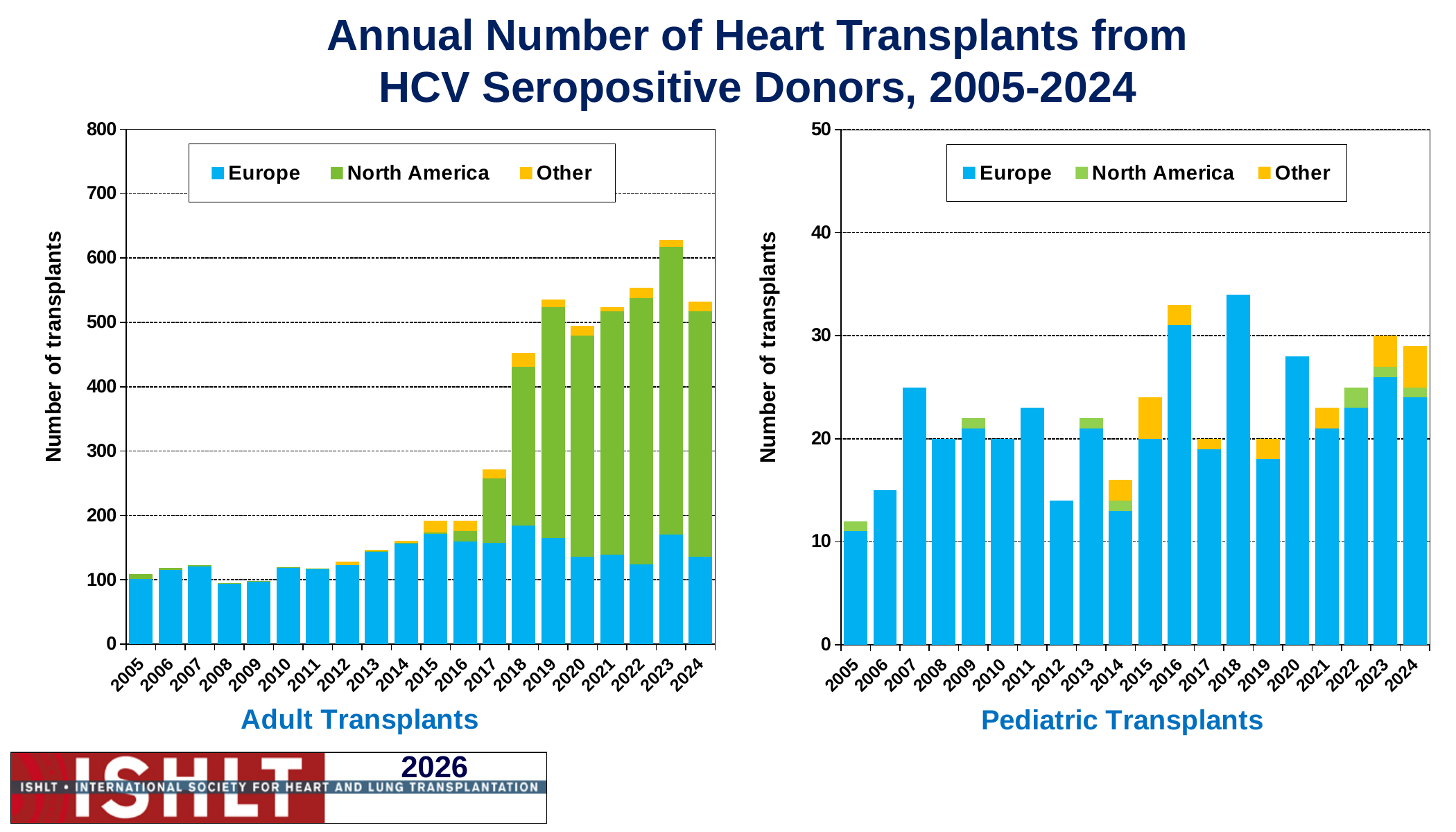
In the Pediatric Transplants chart, is the total for 2012 greater or less than 20? less How many series does the legend of the Pediatric Transplants chart list? 3 What kind of chart is the Adult Transplants chart? bar chart In the Pediatric Transplants chart, which year has the larger total, 2007 or 2012? 2007 In the Pediatric Transplants chart, is the total for 2018 greater or less than 30? greater How many years are shown on the x axis of the Adult Transplants chart? 20 In the Adult Transplants chart, which year has the highest total number of transplants? 2023 In the Adult Transplants chart, is the total for 2017 greater or less than 300? less In the Adult Transplants chart, do the totals generally rise or fall from 2005 to 2023? rise What are the three legend entries in the Adult Transplants chart? Europe, North America, Other